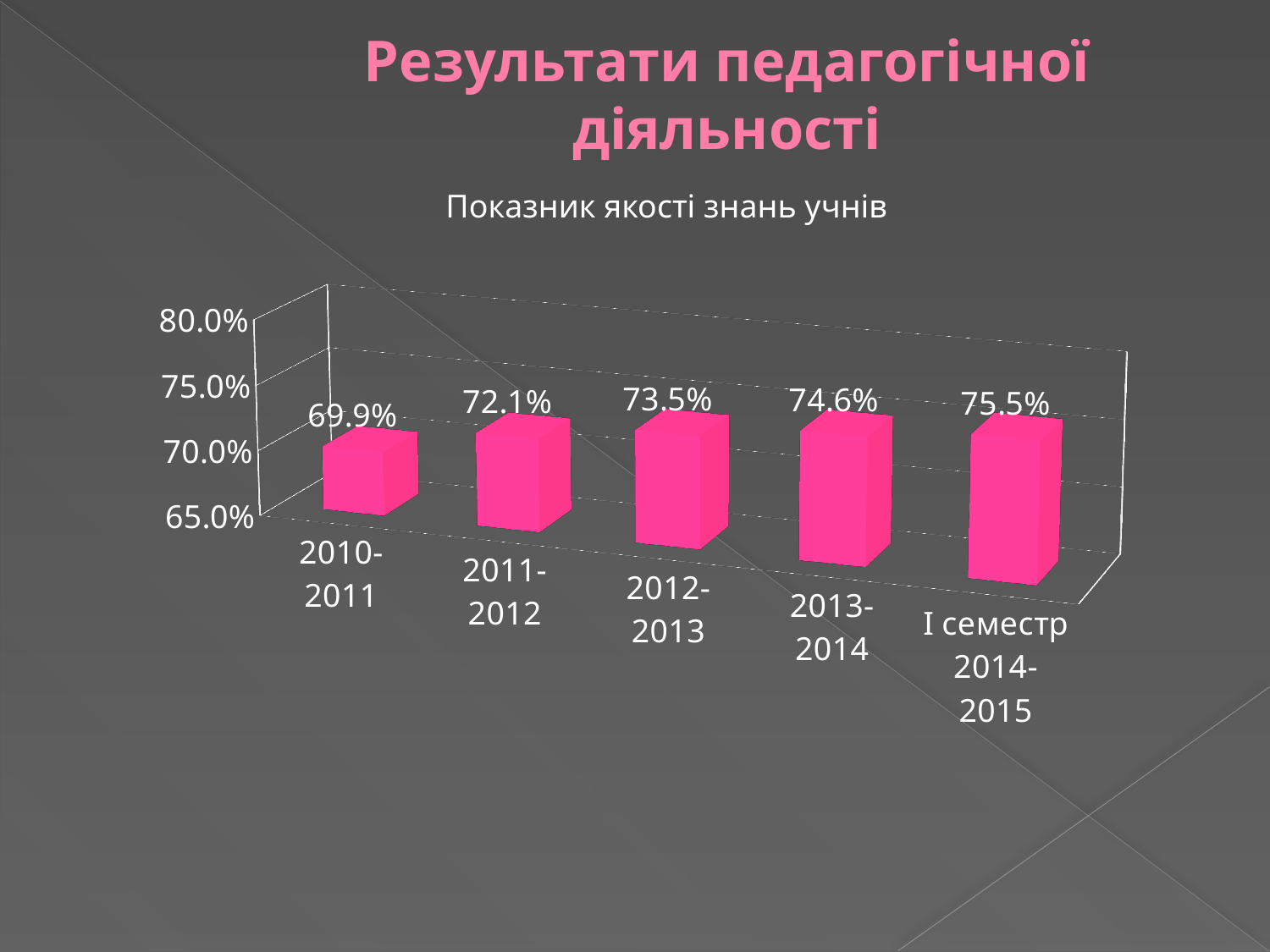
Do the values rise or fall from 2010-2011 to I семестр 2014-2015? rise What kind of chart is shown on the slide? bar chart What is the difference between the values for 2013-2014 and 2010-2011? 4.7% How many categories are shown on the x axis? 5 Which category has the lowest value? 2010-2011 Is the value for 2011-2012 greater or less than 70.0%? greater What is the difference between the values for 2012-2013 and 2011-2012? 1.4% Which category has the highest value? I семестр 2014-2015 What is the value for 2010-2011? 69.9% What is the value for I семестр 2014-2015? 75.5% Which is larger, the value for 2011-2012 or the value for 2013-2014? 2013-2014 What is the value for 2012-2013? 73.5%